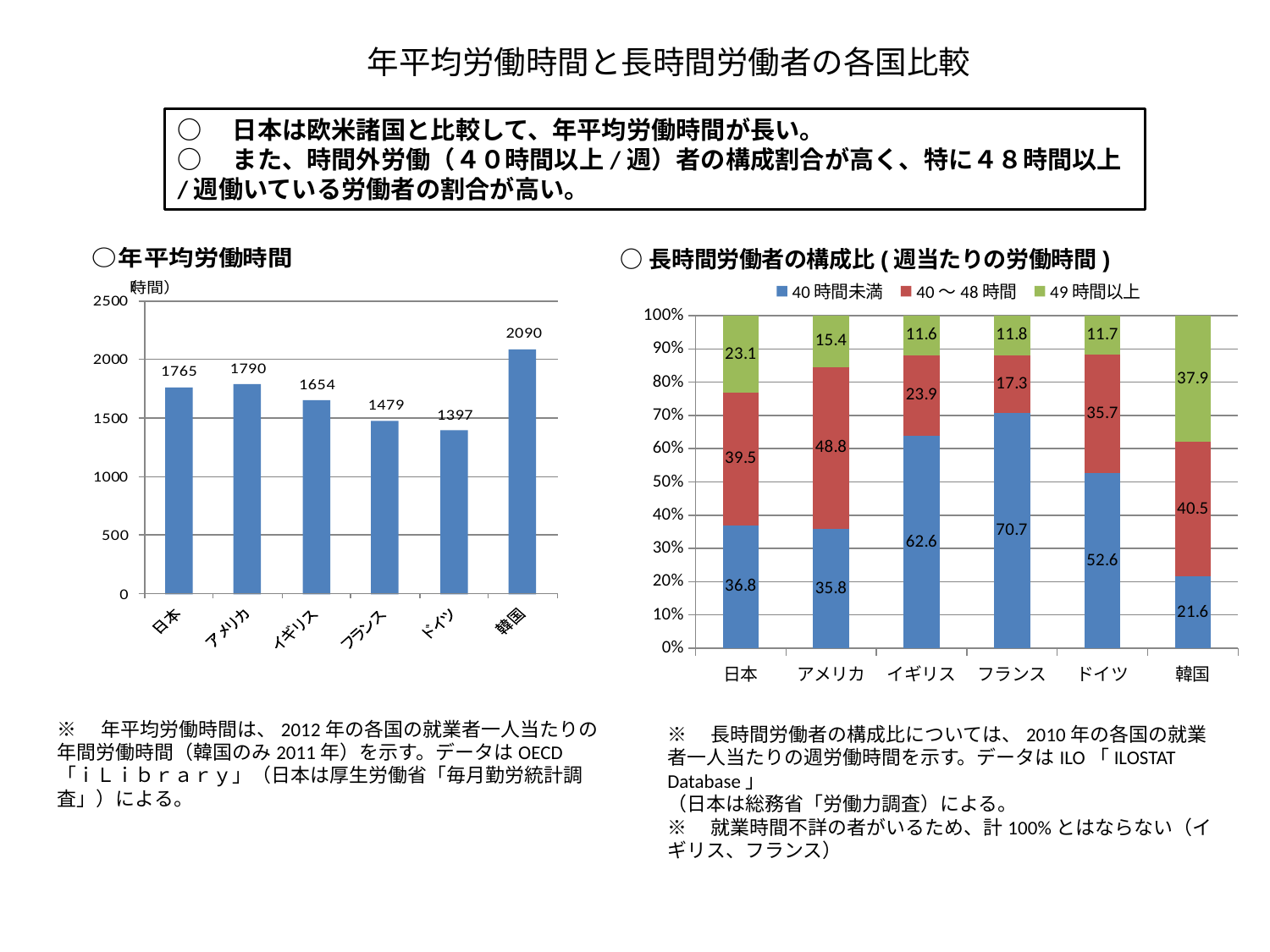
In the 年平均労働時間 chart on the left, which country has the lowest value? ドイツ In the 年平均労働時間 chart on the left, which country has the highest value? 韓国 In the 長時間労働者の構成比 chart on the right, which is larger: the 40時間未満 value for イギリス or for ドイツ? イギリス In the 年平均労働時間 chart on the left, what is the difference between the values for 韓国 and 日本? 325 In the 長時間労働者の構成比 chart on the right, what is the 49時間以上 value for 韓国? 37.9 In the 長時間労働者の構成比 chart on the right, what is the 40時間未満 value for フランス? 70.7 In the 年平均労働時間 chart on the left, what is the value for ドイツ? 1397 In the 長時間労働者の構成比 chart on the right, which country has the highest 40～48時間 value? アメリカ In the 年平均労働時間 chart on the left, what is the value for 韓国? 2090 In the 長時間労働者の構成比 chart on the right, how many series does the legend list? 3 In the 年平均労働時間 chart on the left, how many countries are shown? 6 What kind of chart is the 長時間労働者の構成比 chart on the right? Stacked bar chart